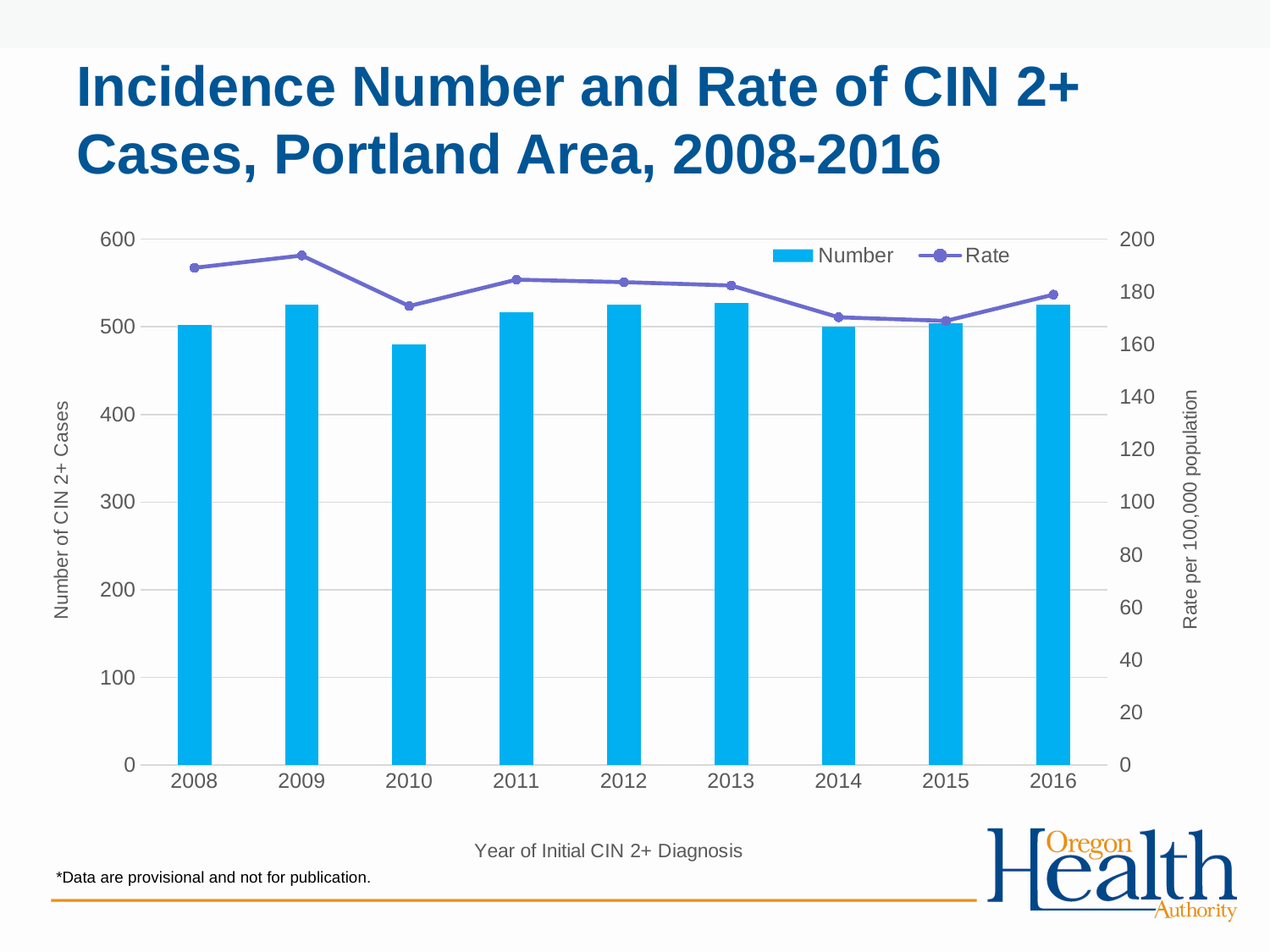
Which year has a larger Number of CIN 2+ cases, 2010 or 2011? 2011 Which year has the lowest Number of CIN 2+ cases? 2010 Is the Rate for 2015 greater or less than 180? less Does the Rate rise or fall from 2013 to 2015? fall Is the Rate for 2008 greater or less than 180? greater How many series does the legend list? 2 How many years are shown on the x axis? 9 What is the label of the x axis? Year of Initial CIN 2+ Diagnosis Is the Number of CIN 2+ cases for 2010 greater or less than 500? less Which year has the highest Rate per 100,000 population? 2009 What kind of chart is shown on the slide? A bar chart combined with a line chart